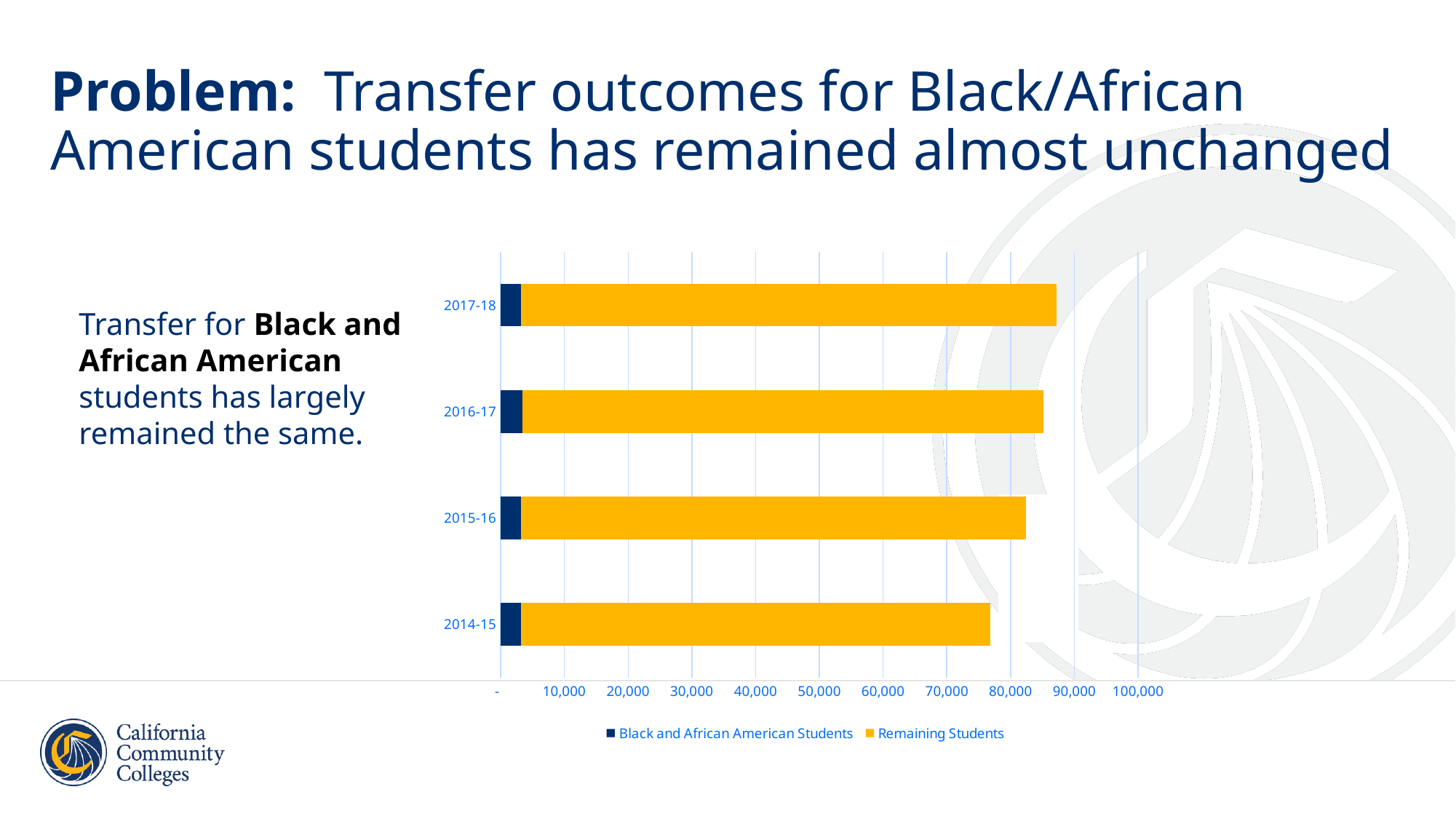
Is the Black and African American Students segment for 2016-17 greater or less than 10,000? less Which total bar is longer, 2016-17 or 2014-15? 2016-17 Which academic year has the shortest total bar? 2014-15 Is the total bar for 2017-18 greater or less than 80,000? greater Which academic year has the longest total bar? 2017-18 Do the total bars get longer or shorter from 2014-15 to 2017-18? longer Which series is shown in yellow in the legend? Remaining Students How many series does the chart legend list? 2 Is the total bar for 2014-15 greater or less than 80,000? less What kind of chart is shown on the slide? Bar chart How many academic years are plotted on the chart? 4